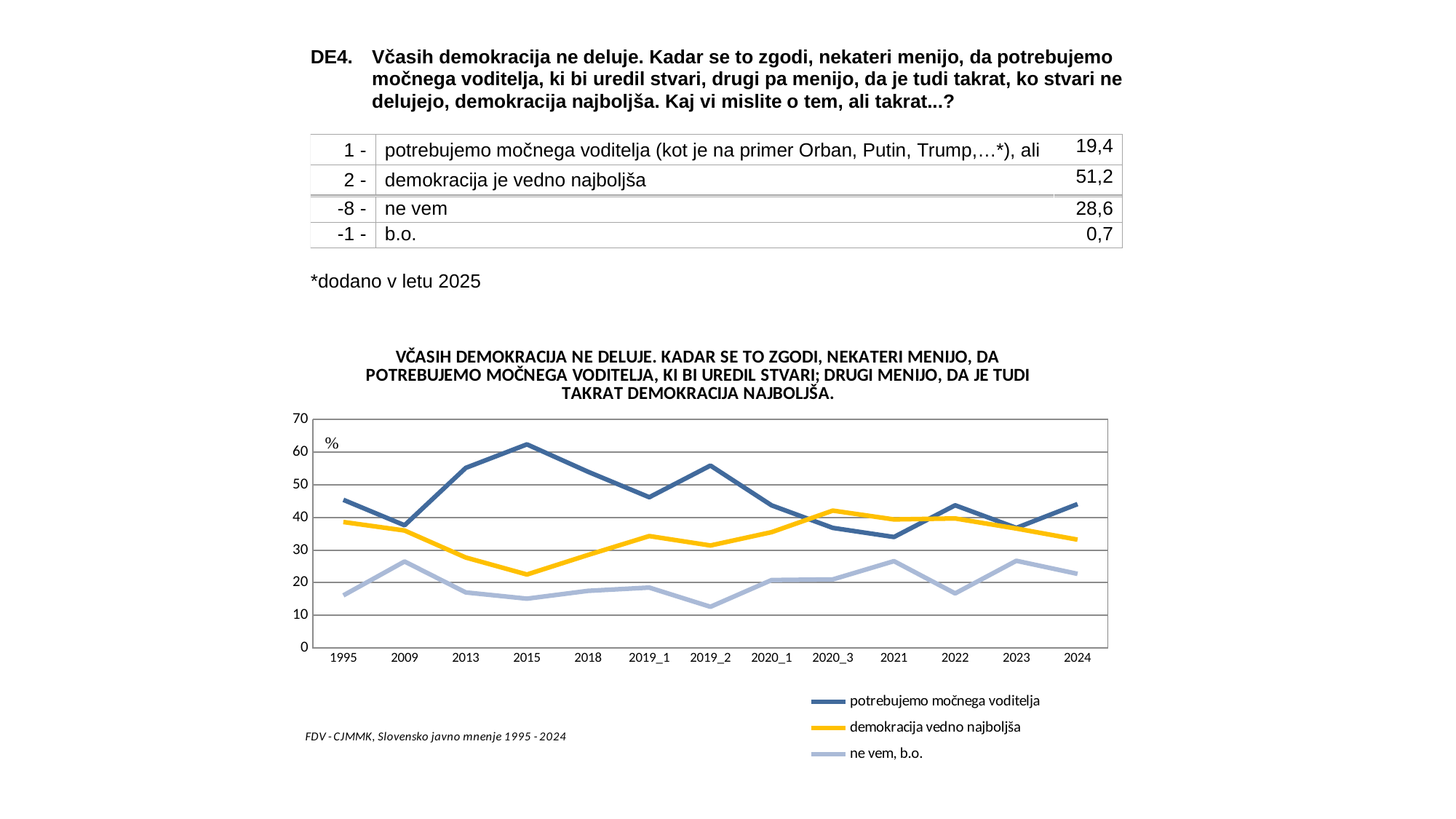
How many series does the chart legend list? 3 In which year does the series 'demokracija vedno najboljša' reach its lowest value? 2015 Is the value for 'demokracija vedno najboljša' in 2015 greater or less than 30? less Is the value for 'potrebujemo močnega voditelja' in 2019_2 greater or less than 50? greater Does the series 'demokracija vedno najboljša' rise or fall from 1995 to 2015? fall Is the value for 'ne vem, b.o.' in 2019_2 greater or less than 20? less In which year does the series 'ne vem, b.o.' reach its lowest value? 2019_2 What colour is the line for 'demokracija vedno najboljša' in the chart? yellow In which year does the series 'potrebujemo močnega voditelja' reach its highest value? 2015 What kind of chart is shown on the slide? line chart In 1995, which series has the higher value: 'potrebujemo močnega voditelja' or 'demokracija vedno najboljša'? potrebujemo močnega voditelja How many time points are shown along the x axis of the chart? 13